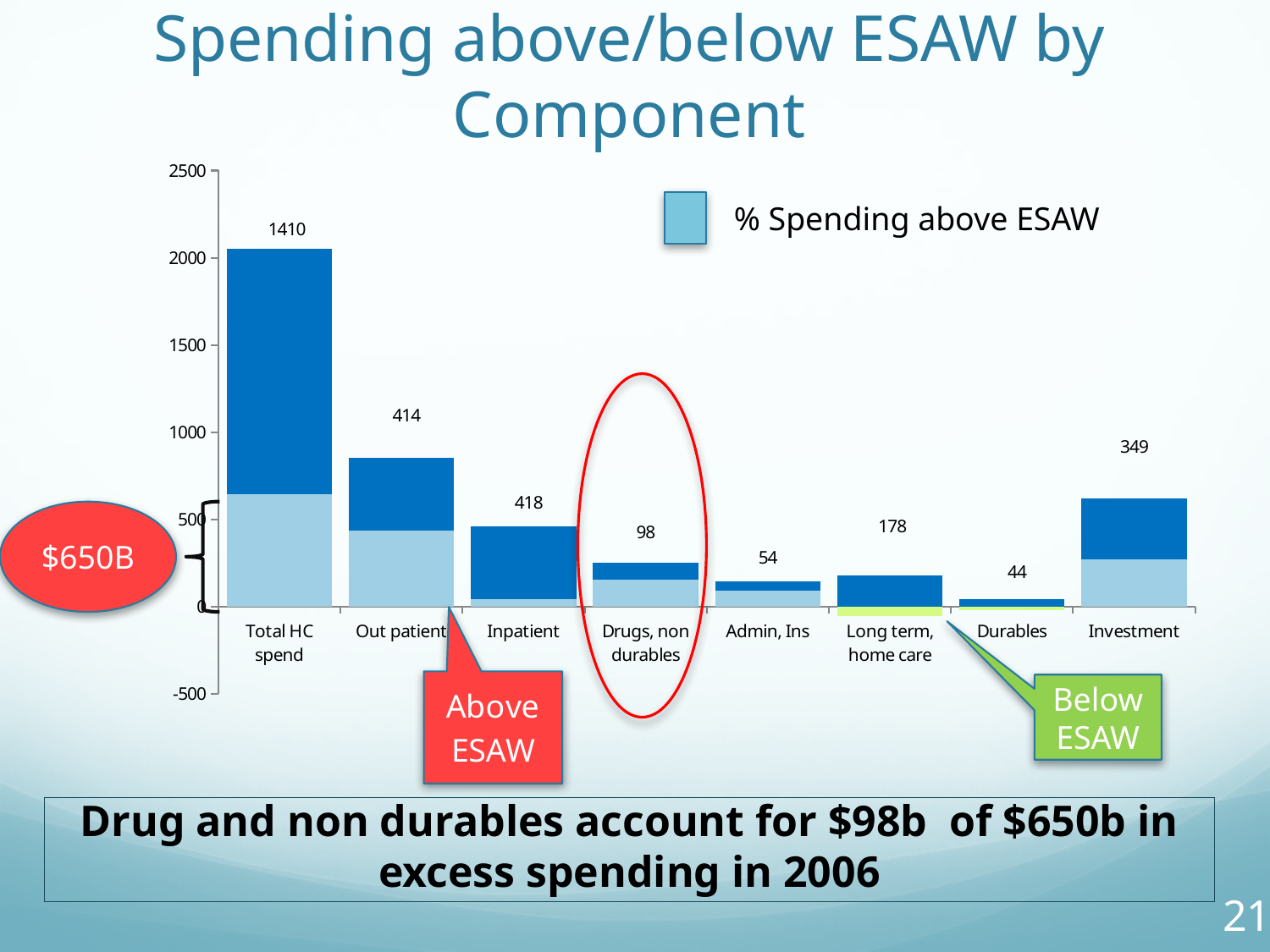
What is the difference between the labelled values for Investment and Long term, home care? 171 Which category has the highest labelled value? Total HC spend What is the difference between the labelled values for Total HC spend and Out patient? 996 What is the data label shown for Total HC spend? 1410 What is the data label shown for Long term, home care? 178 How many categories are shown on the x axis? 8 Which has the larger labelled value, Admin, Ins or Long term, home care? Long term, home care What is the data label shown for Investment? 349 What kind of chart is shown on the slide? bar chart Is the top of the Total HC spend bar greater or less than 2000? greater Which category has the lowest labelled value? Durables What is the data label shown for Drugs, non durables? 98